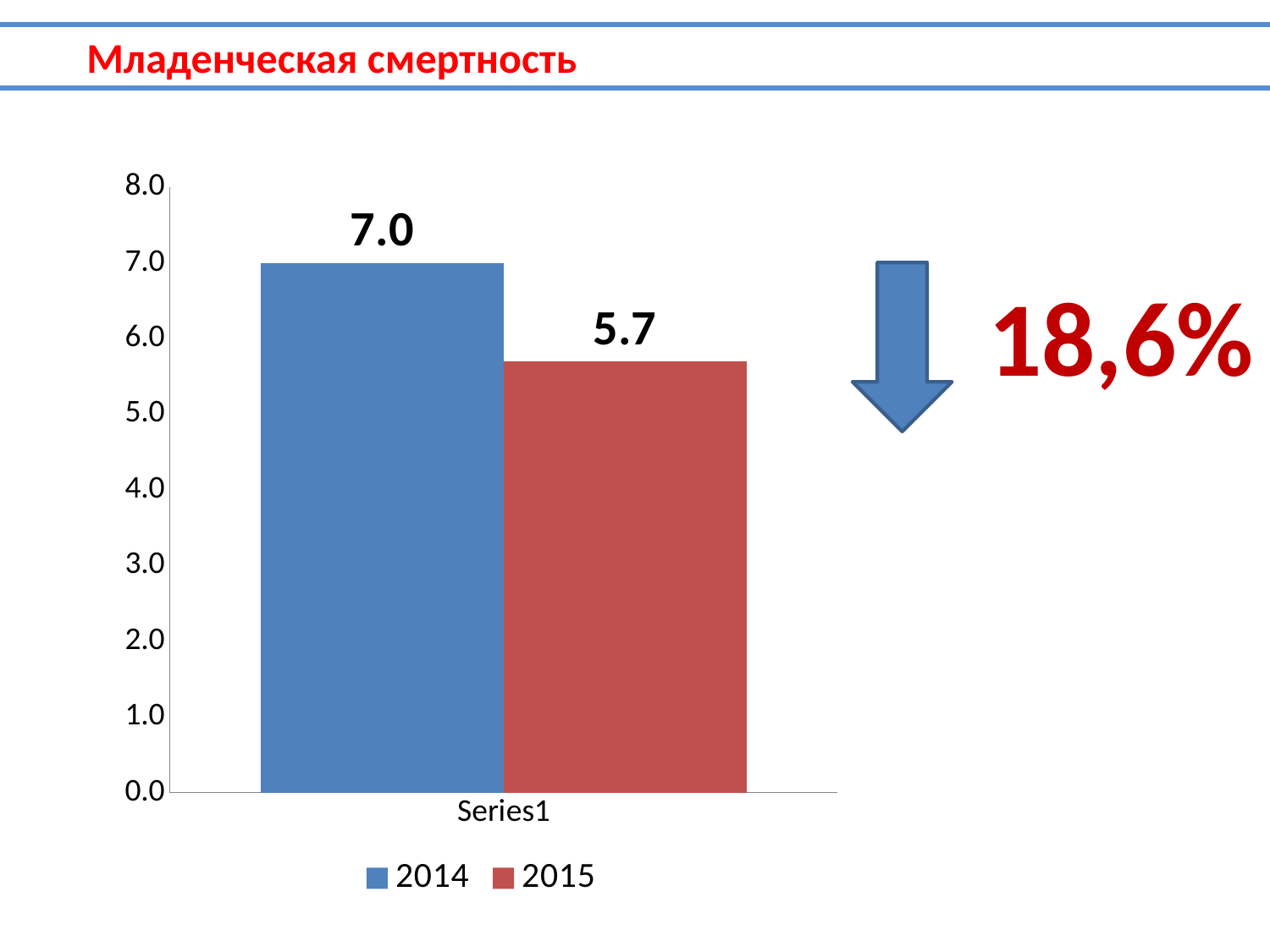
What is the title of the slide? Младенческая смертность Which series has the lowest value? 2015 What kind of chart is shown on the slide? bar chart What percentage is shown next to the downward arrow? 18,6% Is the value for 2015 greater or less than 6.0? less What is the value for 2014? 7.0 Which year has the higher value, 2014 or 2015? 2014 What is the value for 2015? 5.7 Is the value for 2014 greater or less than 6.0? greater What is the difference between the 2014 and 2015 values? 1.3 How many series does the legend list? 2 Which series has the highest value? 2014